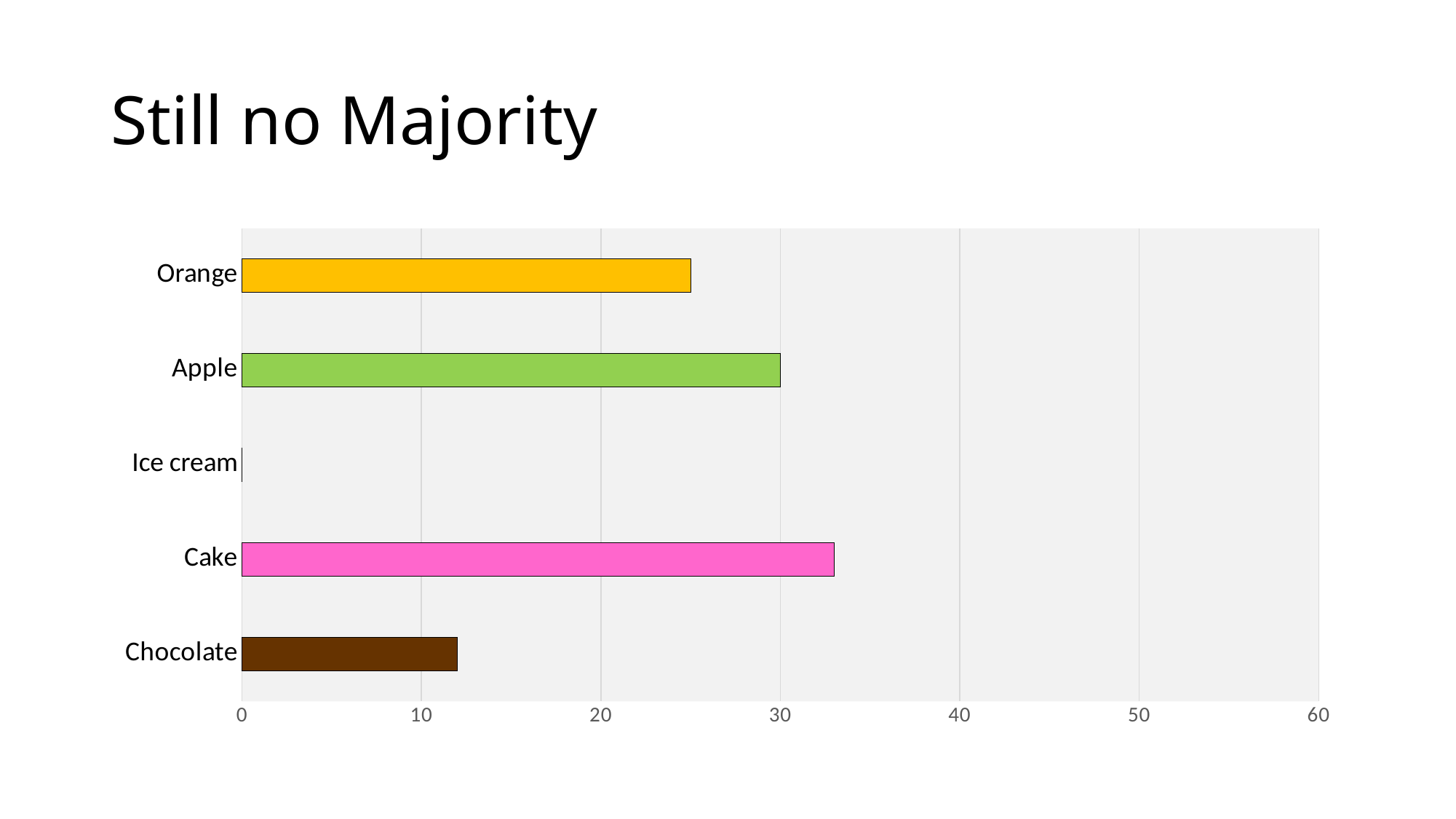
Is the value for Cake greater or less than 30? greater Which is larger, the value for Chocolate or the value for Orange? Orange How many categories are shown in the chart? 5 What kind of chart is shown on the slide? bar chart Is the value for Orange greater or less than 20? greater What is the title of the slide? Still no Majority What is the value for Ice cream? 0 Which is larger, the value for Apple or the value for Orange? Apple Which category has the lowest value? Ice cream Which category has the highest value? Cake What is the value for Apple? 30 Is the value for Chocolate greater or less than 20? less